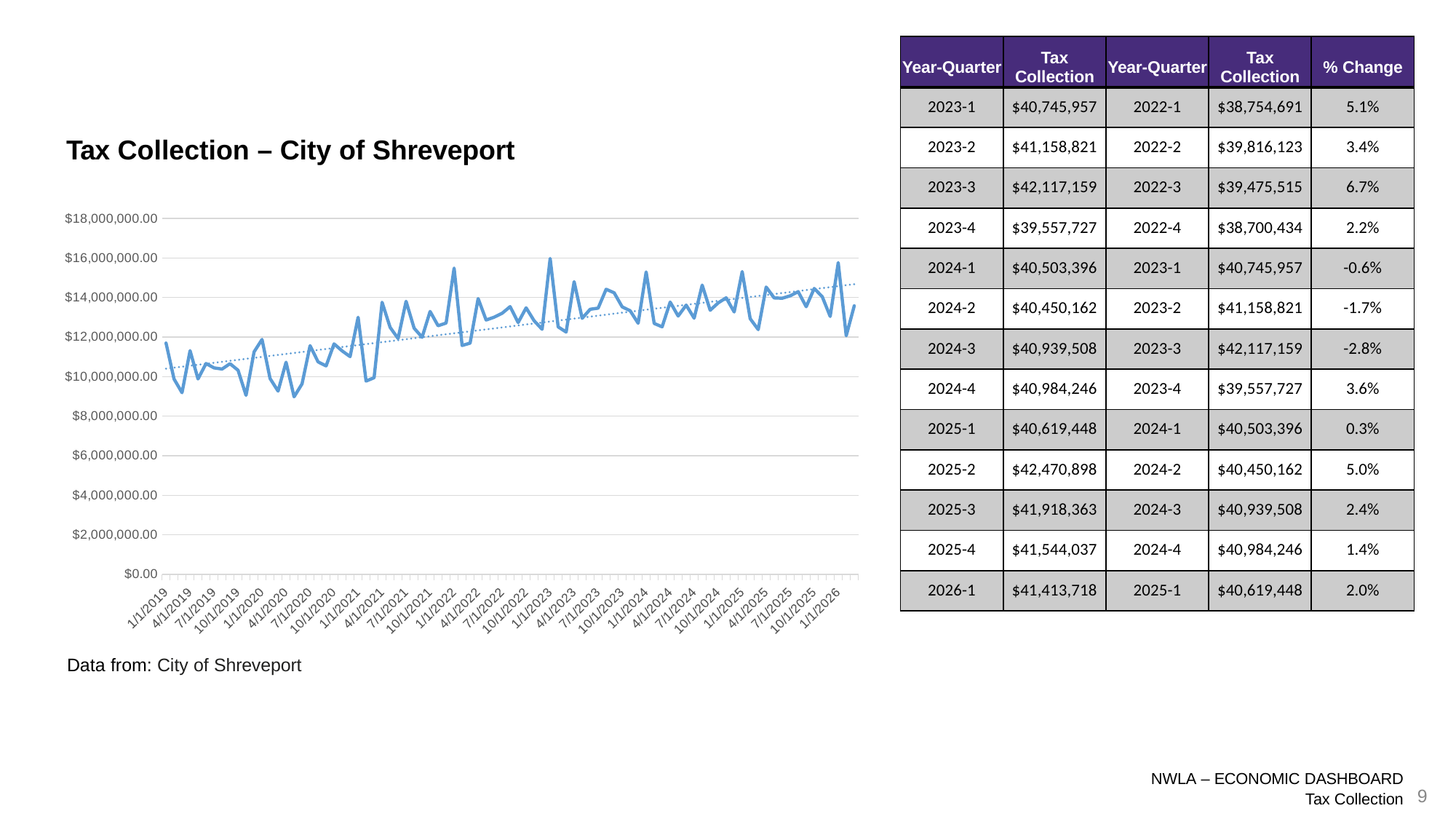
Overall, do the values in the chart rise or fall from 1/1/2019 to 1/1/2026? rise Is the value at 4/1/2020 greater or less than $10,000,000.00? greater What is the highest tick label on the chart's vertical axis? $18,000,000.00 Is the value at 1/1/2019 greater or less than $10,000,000.00? greater What is the title of the chart? Tax Collection – City of Shreveport Is the value at 1/1/2023 greater or less than $14,000,000.00? greater What kind of chart is shown on the slide? line chart Which is larger, the value at 1/1/2023 or the value at 1/1/2019? 1/1/2023 Which is larger, the value at 1/1/2019 or the value at 4/1/2020? 1/1/2019